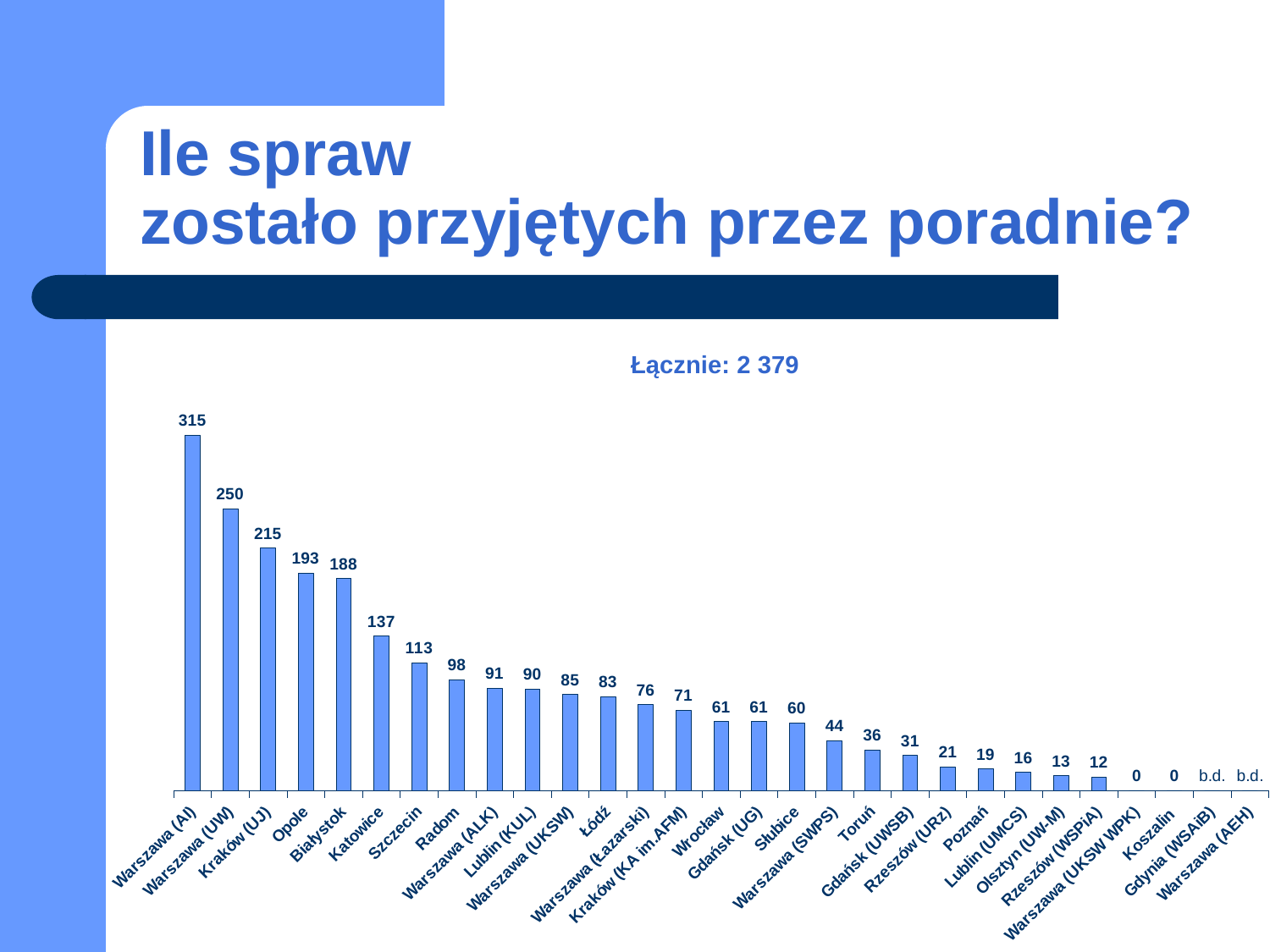
What value is shown for Lublin (KUL)? 90 What value is shown for Katowice? 137 Which category has the highest value? Warszawa (AI) What value is shown for Toruń? 36 What total is stated above the chart (Łącznie)? 2 379 What is the difference between the values for Opole and Białystok? 5 Do the values rise or fall from left to right along the x axis? fall Which is larger, the value for Poznań or the value for Rzeszów (URz)? Rzeszów (URz) What kind of chart is shown on the slide? bar chart What value is shown for Warszawa (AI)? 315 Which is larger, the value for Szczecin or the value for Radom? Szczecin What is the difference between the values for Warszawa (UW) and Kraków (UJ)? 35